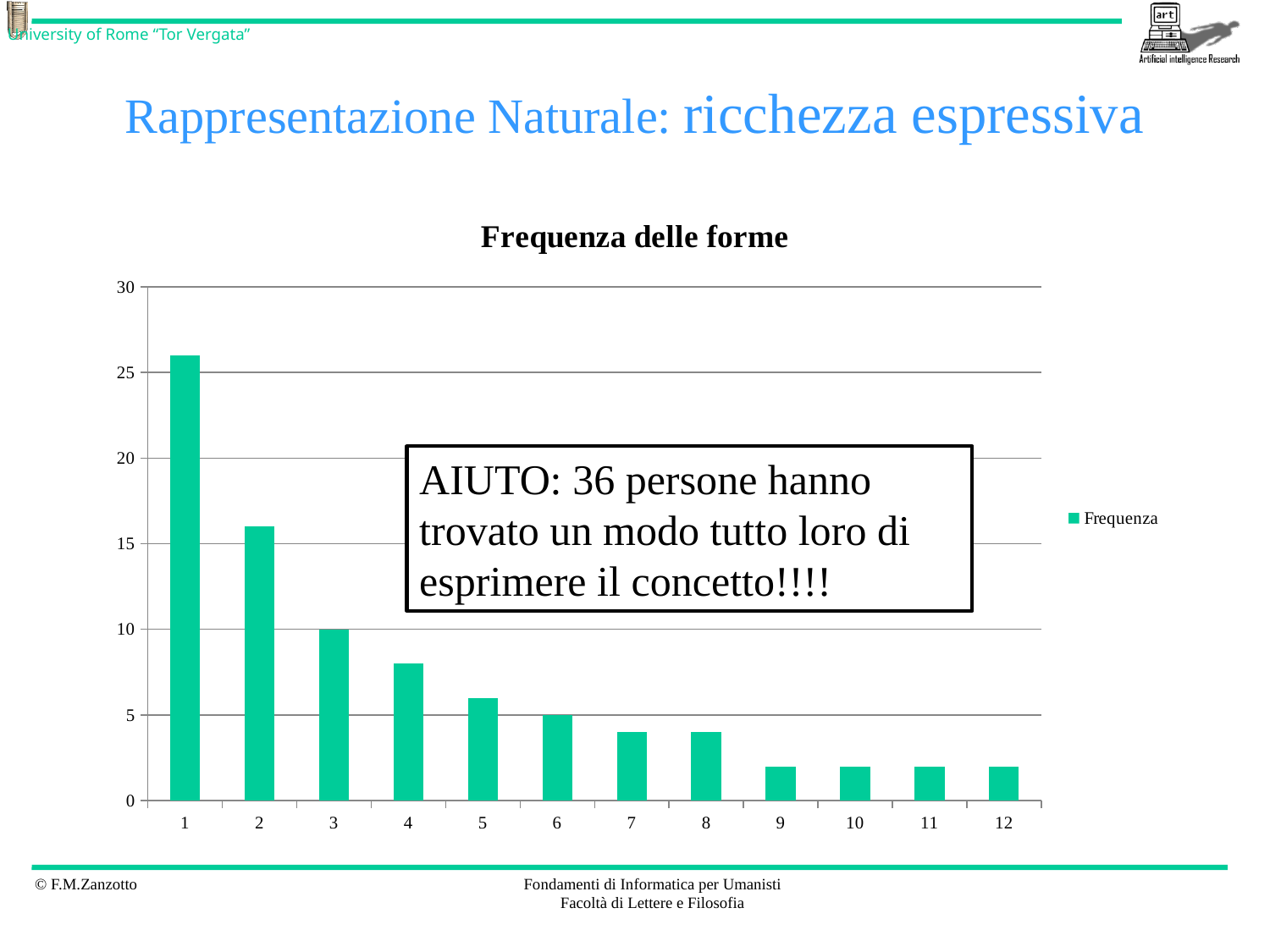
What is the title of the chart? Frequenza delle forme What kind of chart is shown on the slide? Bar chart What is the value for category 6? 5 What is the value for category 3? 10 Which category has the highest value? 1 Do the values rise or fall as you move from category 1 to category 12? Fall What is the name of the series shown in the legend? Frequenza How many series does the legend list? 1 Is the value for category 4 greater or less than 10? less Is the value for category 1 greater or less than 25? greater Which has a larger value, category 2 or category 5? 2 How many categories are shown on the x axis of the chart? 12